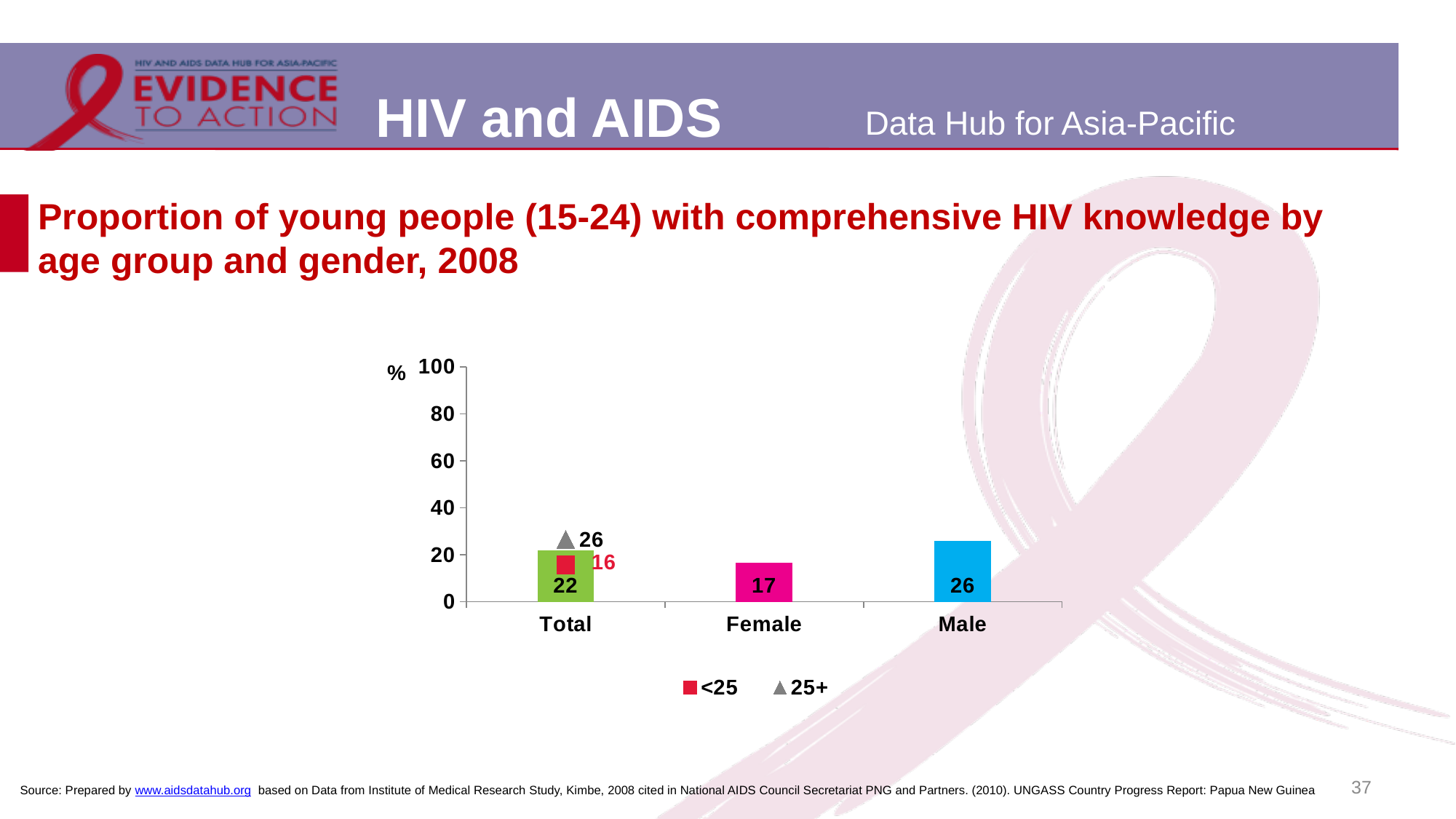
What is the value of the 25+ marker shown for Total? 26 Which category has the highest bar value? Male How many series does the legend list? 2 What is the value of the <25 marker shown for Total? 16 What kind of chart is shown on the slide? Bar chart What is the value of the bar for Female? 17 What is the value of the bar for Male? 26 Which is larger, the bar value for Total or for Female? Total How many categories are shown on the x axis? 3 What is the value of the bar for Total? 22 What is the difference between the Male and Female bar values? 9 Which category has the lowest bar value? Female